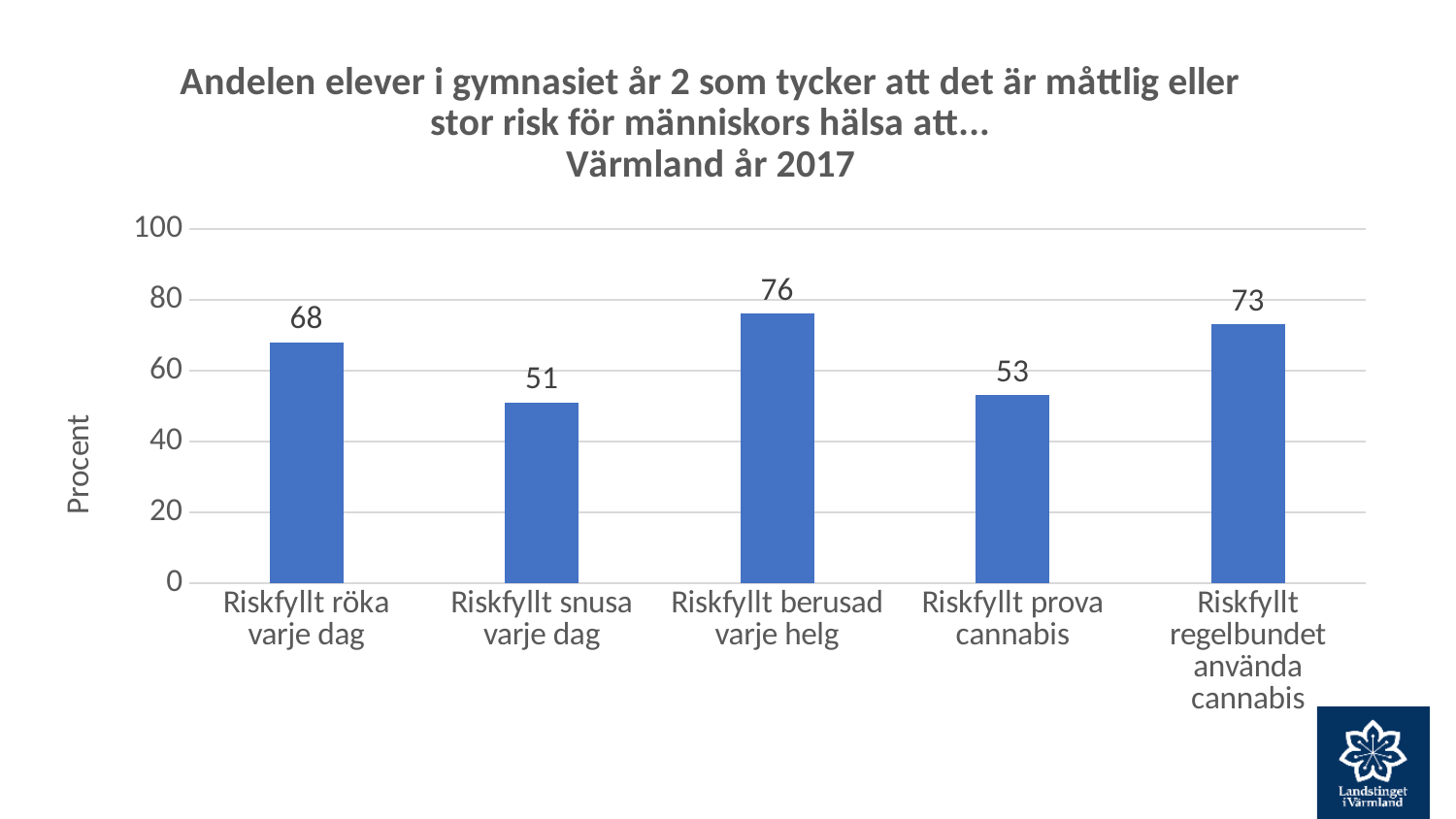
What is the value for 'Riskfyllt snusa varje dag'? 51 What kind of chart is shown on the slide? Bar chart Which is larger, the value for 'Riskfyllt röka varje dag' or 'Riskfyllt regelbundet använda cannabis'? Riskfyllt regelbundet använda cannabis Which category has the highest value? Riskfyllt berusad varje helg What is the value for 'Riskfyllt regelbundet använda cannabis'? 73 What is the label of the vertical axis? Procent What is the value for 'Riskfyllt prova cannabis'? 53 What is the value for 'Riskfyllt röka varje dag'? 68 Which category has the lowest value? Riskfyllt snusa varje dag How many categories are shown in the chart? 5 What is the difference between the values for 'Riskfyllt berusad varje helg' and 'Riskfyllt snusa varje dag'? 25 What is the value for 'Riskfyllt berusad varje helg'? 76